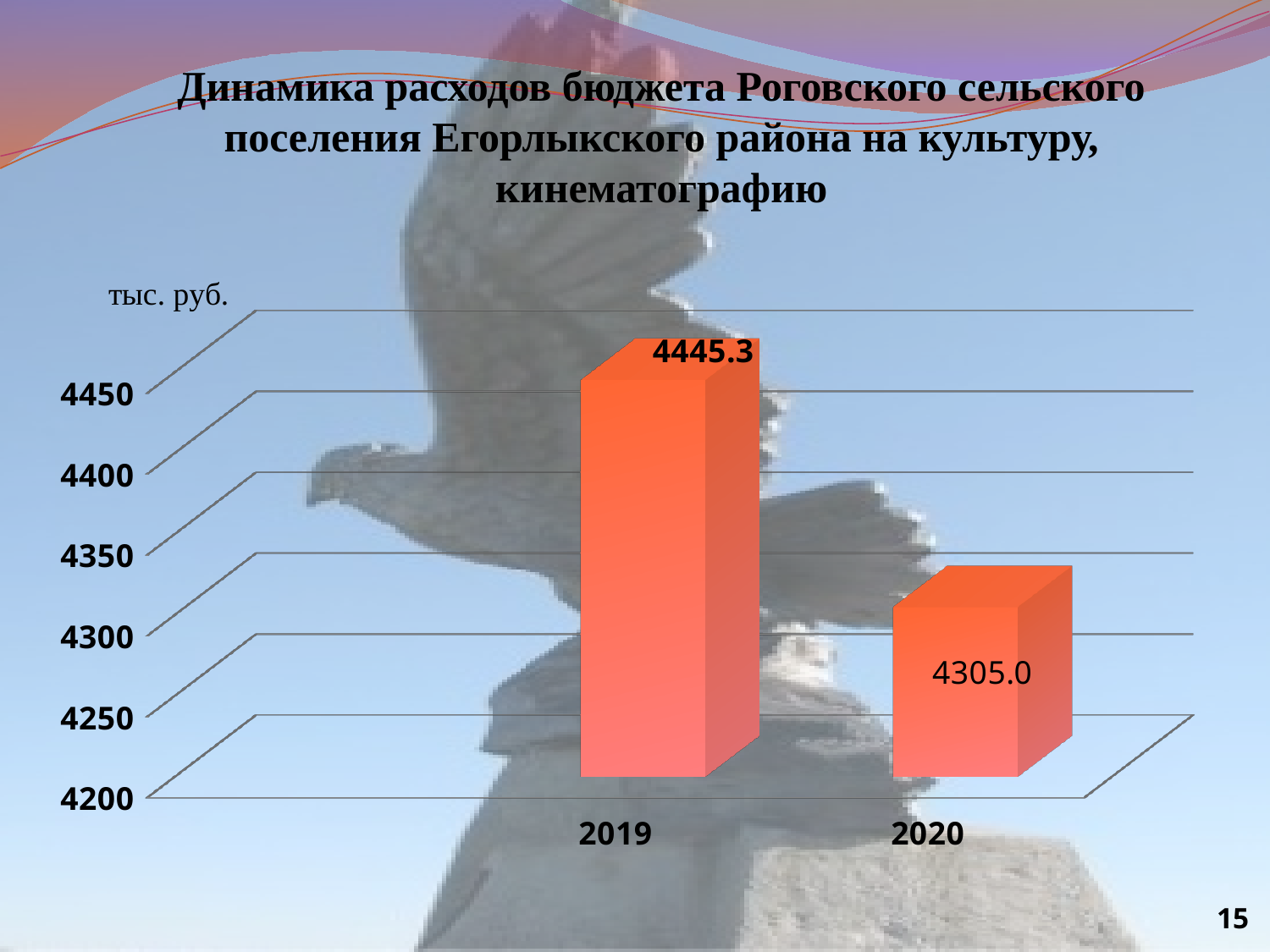
What is the value for 2020? 4305.0 Do the values rise or fall from 2019 to 2020? fall What unit is indicated above the vertical axis? тыс. руб. What is the difference between the values for 2019 and 2020? 140.3 What kind of chart is shown on the slide? bar chart Which year has the highest value? 2019 Is the value for 2020 greater or less than 4350? less Which is larger, the value for 2019 or the value for 2020? 2019 How many categories are shown on the x axis? 2 Which year has the lowest value? 2020 What is the value for 2019? 4445.3 Is the value for 2019 greater or less than 4400? greater